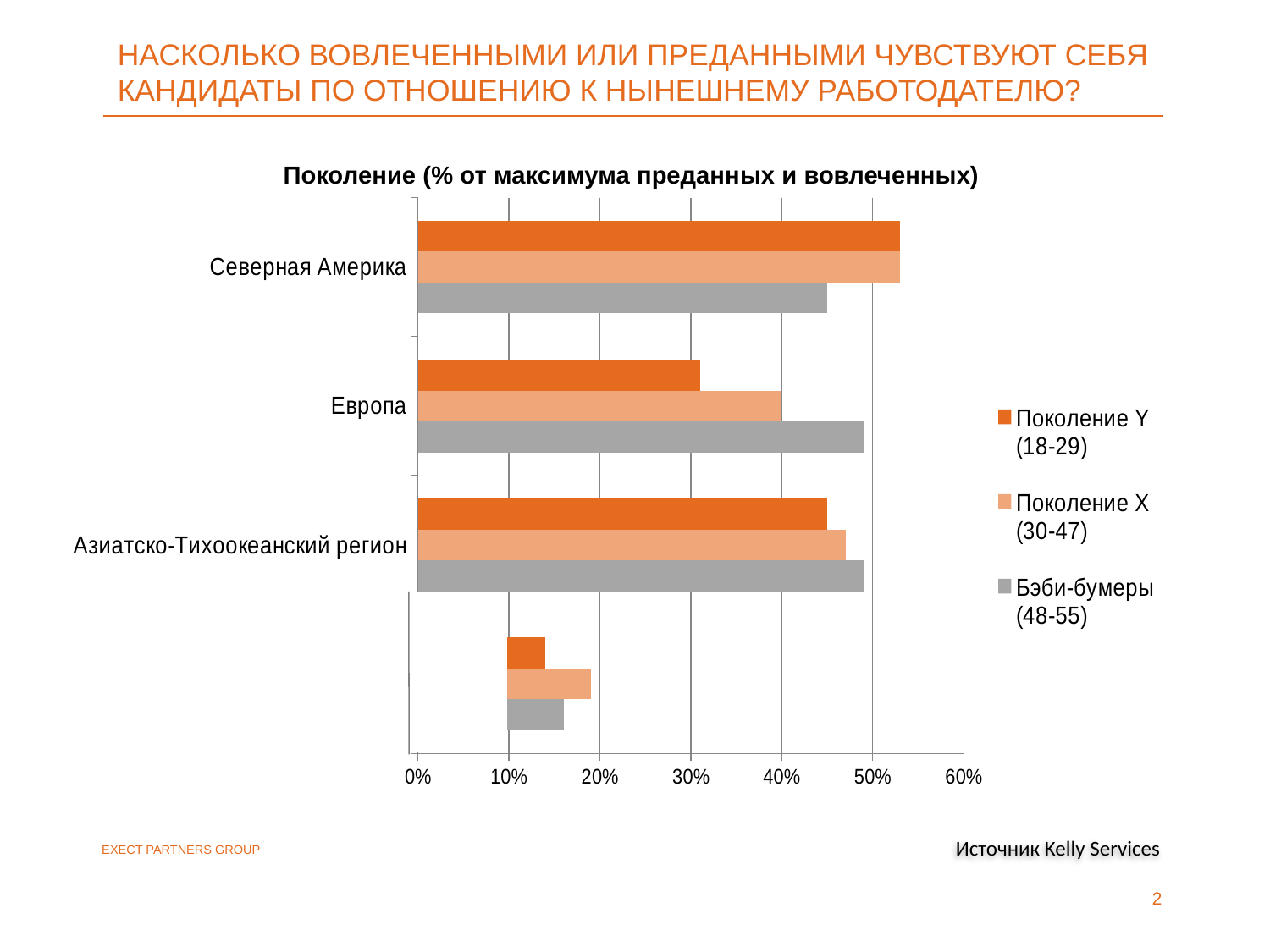
Is the value for Поколение Y (18-29) in Северная Америка greater or less than 50%? greater Is the value for Бэби-бумеры (48-55) in Северная Америка greater or less than 50%? less In Европа, which is larger: the value for Поколение Y (18-29) or for Бэби-бумеры (48-55)? Бэби-бумеры (48-55) Which series is shown in grey in the legend? Бэби-бумеры (48-55) In Северная Америка, which is larger: the value for Поколение Y (18-29) or for Бэби-бумеры (48-55)? Поколение Y (18-29) How many series does the legend list? 3 Is the value for Бэби-бумеры (48-55) in Европа greater or less than 40%? greater What kind of chart is shown on the slide? bar chart What is the title of the chart? Поколение (% от максимума преданных и вовлеченных) In Европа, which series has the highest value? Бэби-бумеры (48-55) Among the labeled regions, which has the lowest value for Поколение Y (18-29)? Европа